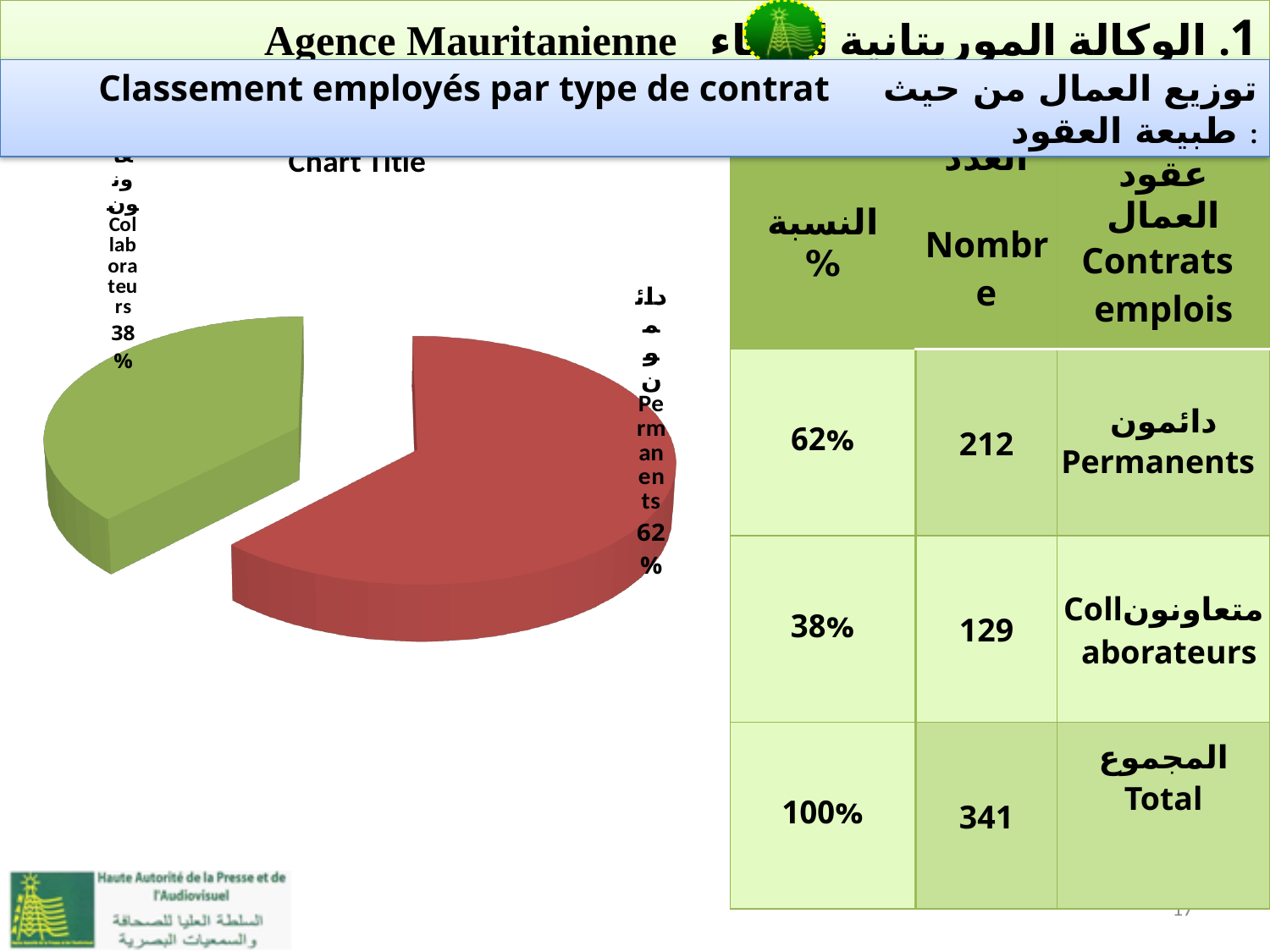
What kind of chart is shown on the slide? pie chart Which slice of the pie chart is the smallest? Collaborateurs Is the share for Collaborateurs greater or less than 50%? less What colour is the Permanents slice of the pie chart? red What is the title printed above the pie chart? Chart Title How many slices does the pie chart have? 2 What share of the pie does the Collaborateurs slice represent? 38% What share of the pie does the Permanents slice represent? 62% What is the difference in percentage points between the Permanents and Collaborateurs slices? 24% Which is larger in the pie chart, Permanents or Collaborateurs? Permanents Which slice of the pie chart is the largest? Permanents